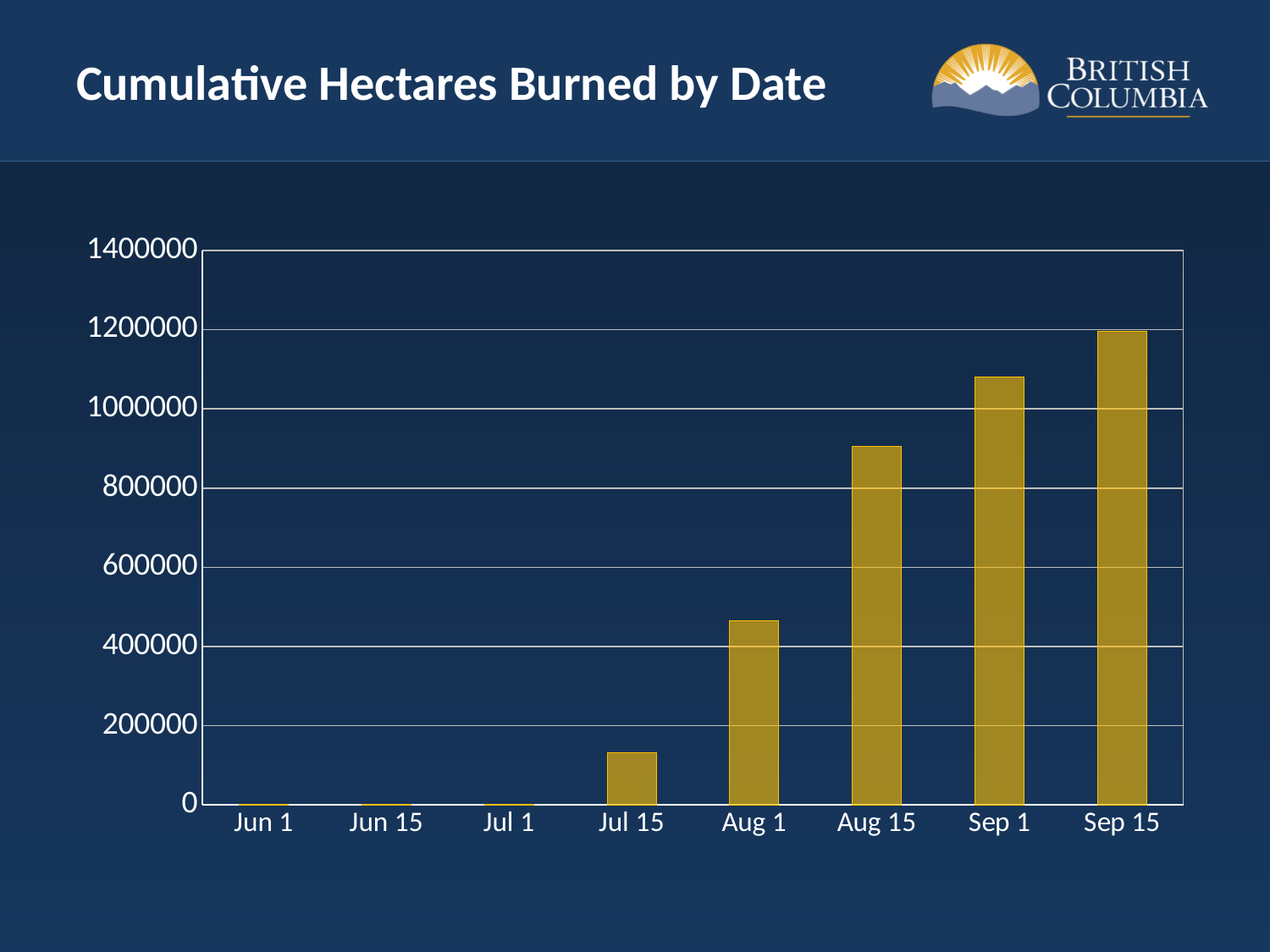
Is the value for Jul 15 greater or less than 200000? less What colour are the bars in the chart? Gold Which is larger, the value for Sep 1 or the value for Sep 15? Sep 15 Is the value for Aug 15 greater or less than 1000000? less Is the value for Sep 1 greater or less than 1000000? greater What is the title of the chart? Cumulative Hectares Burned by Date Which is larger, the value for Aug 1 or the value for Aug 15? Aug 15 Do the values rise or fall from Jun 1 to Sep 15? Rise What type of chart is shown on the slide? Bar chart How many dates are shown on the x axis of the chart? 8 Which date has the highest cumulative hectares burned? Sep 15